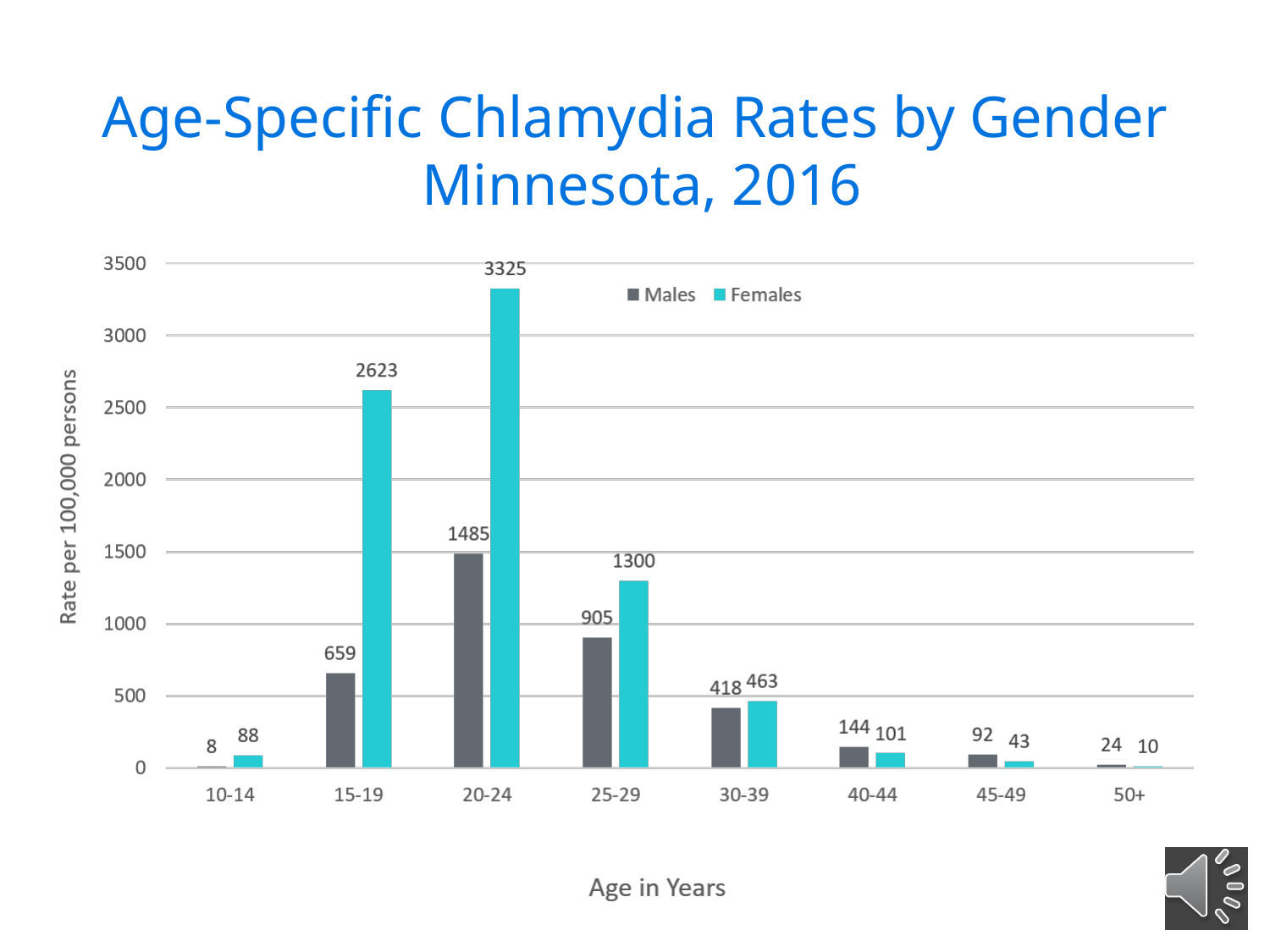
What is the label of the y axis? Rate per 100,000 persons Which is larger, the male rate or the female rate for the 40-44 age group? Male rate What is the chlamydia rate for males aged 25-29? 905 What kind of chart is shown on the slide? Bar chart What is the chlamydia rate for females aged 20-24? 3325 What is the chlamydia rate for females aged 15-19? 2623 Which age group has the lowest rate for females? 50+ How many age groups are shown on the x axis? 8 What is the difference between the female and male rates for the 20-24 age group? 1840 Which age group has the highest rate for males? 20-24 Do the female rates rise or fall from the 20-24 age group to the 50+ age group? Fall How many series does the legend list? 2